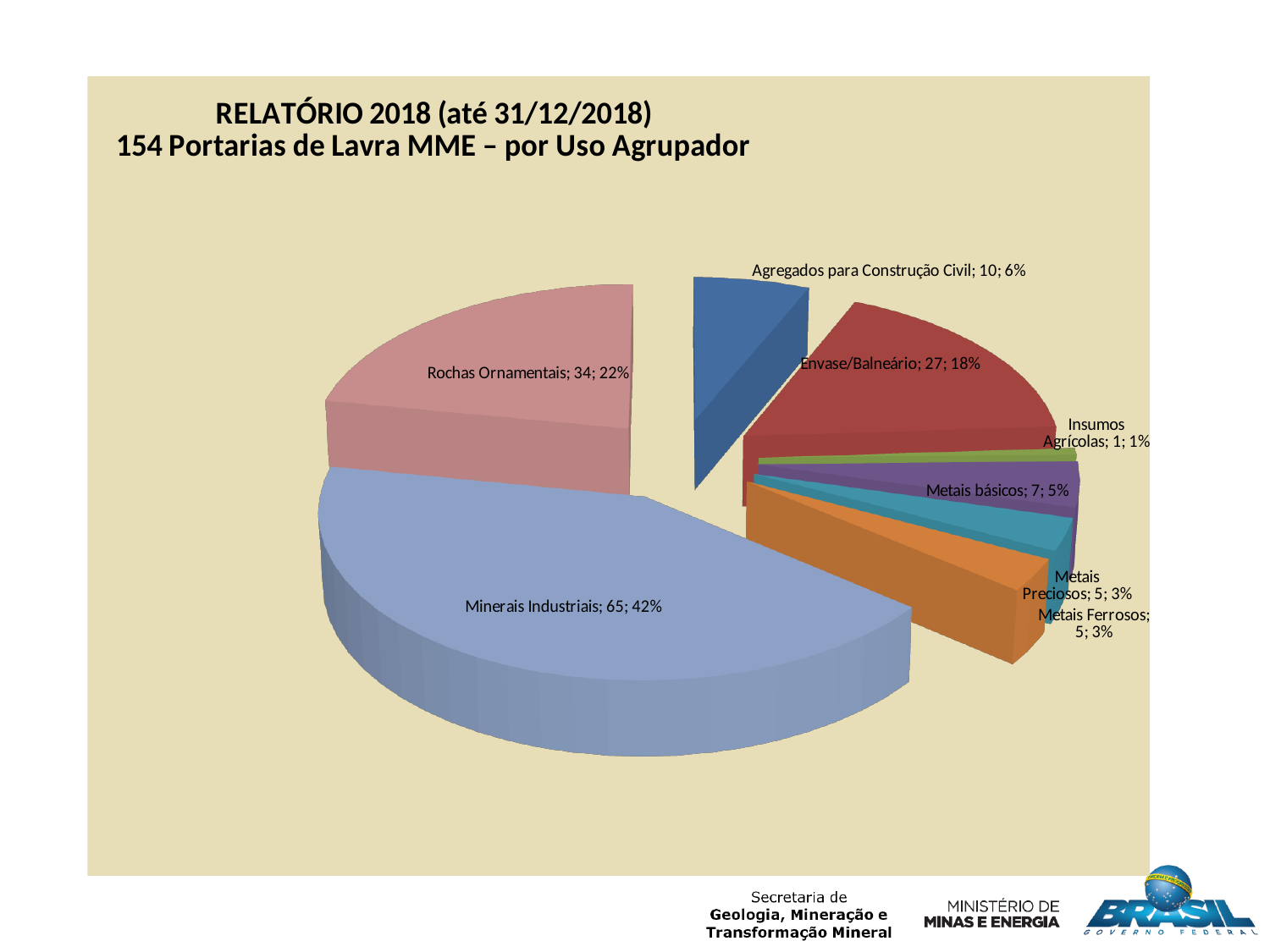
Which category has the smallest slice of the pie chart? Insumos Agrícolas What is the difference between the values for Minerais Industriais and Rochas Ornamentais? 31 What percentage share does Rochas Ornamentais have in the pie chart? 22% How many Portarias de Lavra are shown for Minerais Industriais? 65 How many categories (slices) does the pie chart show? 8 What is the value shown for Envase/Balneário? 27 What kind of chart is shown on the slide? Pie chart Which is larger, the value for Agregados para Construção Civil or the value for Metais básicos? Agregados para Construção Civil What is the value shown for Metais Ferrosos? 5 What is the title of the chart? RELATÓRIO 2018 (até 31/12/2018) 154 Portarias de Lavra MME – por Uso Agrupador Which category has the largest slice of the pie chart? Minerais Industriais What percentage share does Agregados para Construção Civil have? 6%